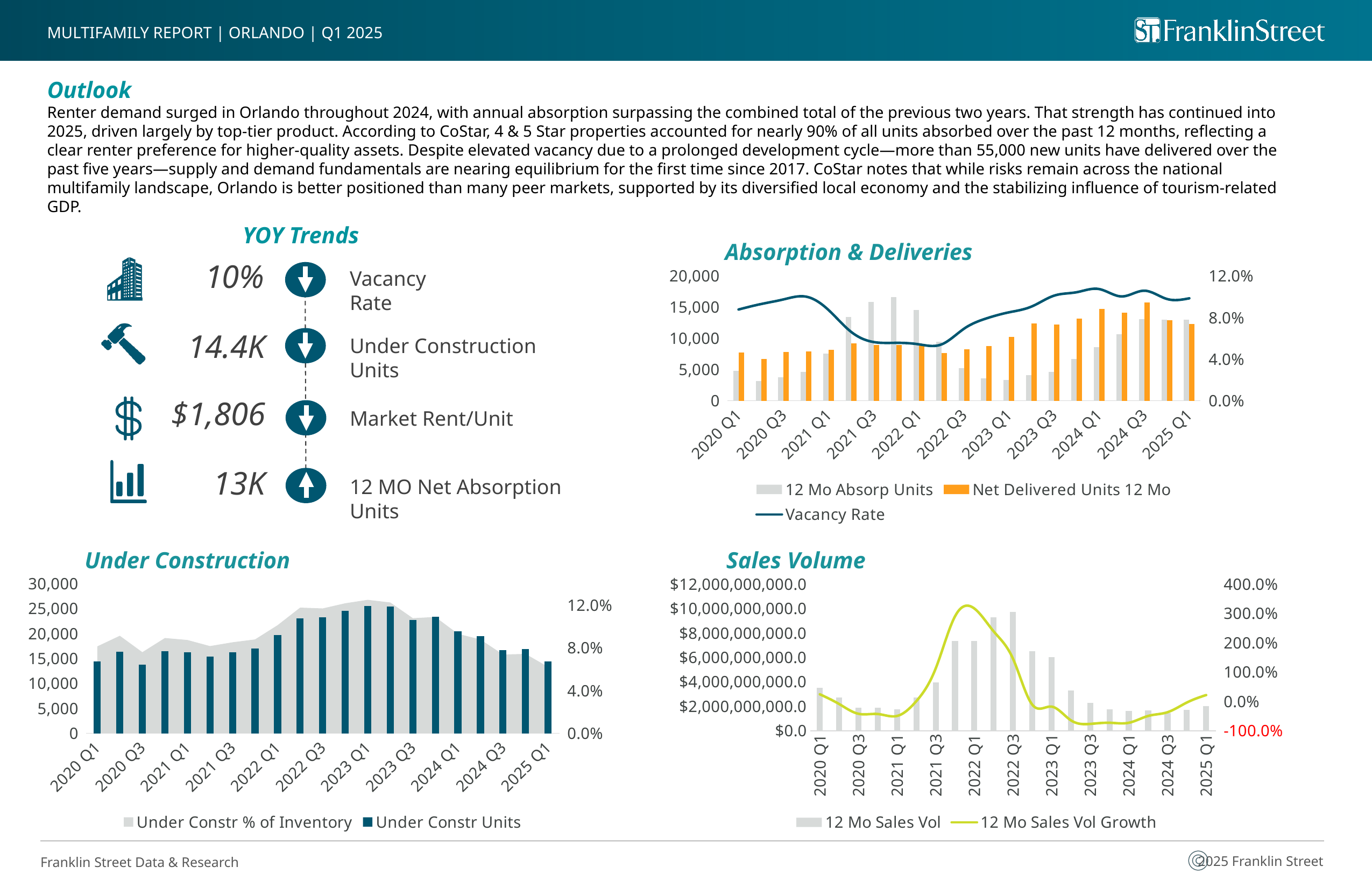
In the Sales Volume chart, is the 12 Mo Sales Vol for 2024 Q1 greater or less than $2,000,000,000.0? less In the Sales Volume chart, which quarter has the highest 12 Mo Sales Vol? 2022 Q3 In the Under Construction chart, do the Under Constr Units rise or fall from 2023 Q1 to 2025 Q1? fall In the Under Construction chart, is the Under Constr Units value for 2023 Q1 greater or less than 20,000? greater How many quarters are plotted on the x axis of the Under Construction chart? 21 In the Absorption & Deliveries chart, is the Vacancy Rate for 2024 Q1 greater or less than 8.0%? greater How many series does the legend of the Absorption & Deliveries chart list? 3 How many series does the legend of the Under Construction chart list? 2 In the Absorption & Deliveries chart, which colour represents Net Delivered Units 12 Mo? Orange What kind of chart is the Absorption & Deliveries chart? Combination bar and line chart